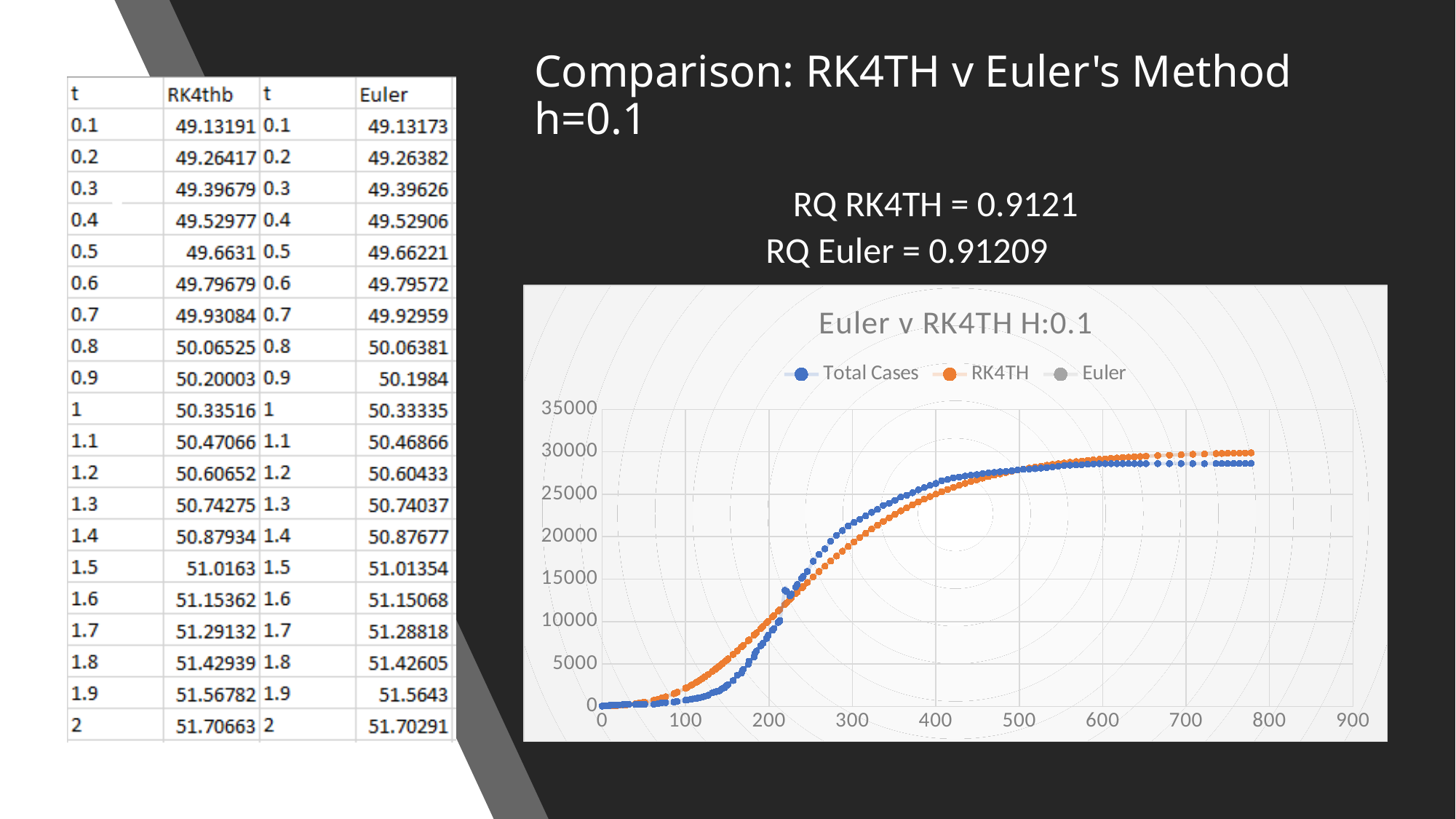
Is the RK4TH value at x = 300 greater or less than 15000? greater Is the RK4TH value at x = 700 greater or less than 25000? greater Which series are listed in the chart's legend? Total Cases, RK4TH, Euler Is the Total Cases value at x = 200 greater or less than 10000? less What is the highest value shown on the chart's y axis? 35000 What is the title of the chart on the slide? Euler v RK4TH H:0.1 How many series does the chart's legend list? 3 At x = 700, which series has the larger value, RK4TH or Total Cases? RK4TH What kind of chart is shown on the slide? scatter chart At x = 300, which series has the larger value, Total Cases or RK4TH? Total Cases Do the Total Cases values rise or fall as the x axis increases? rise